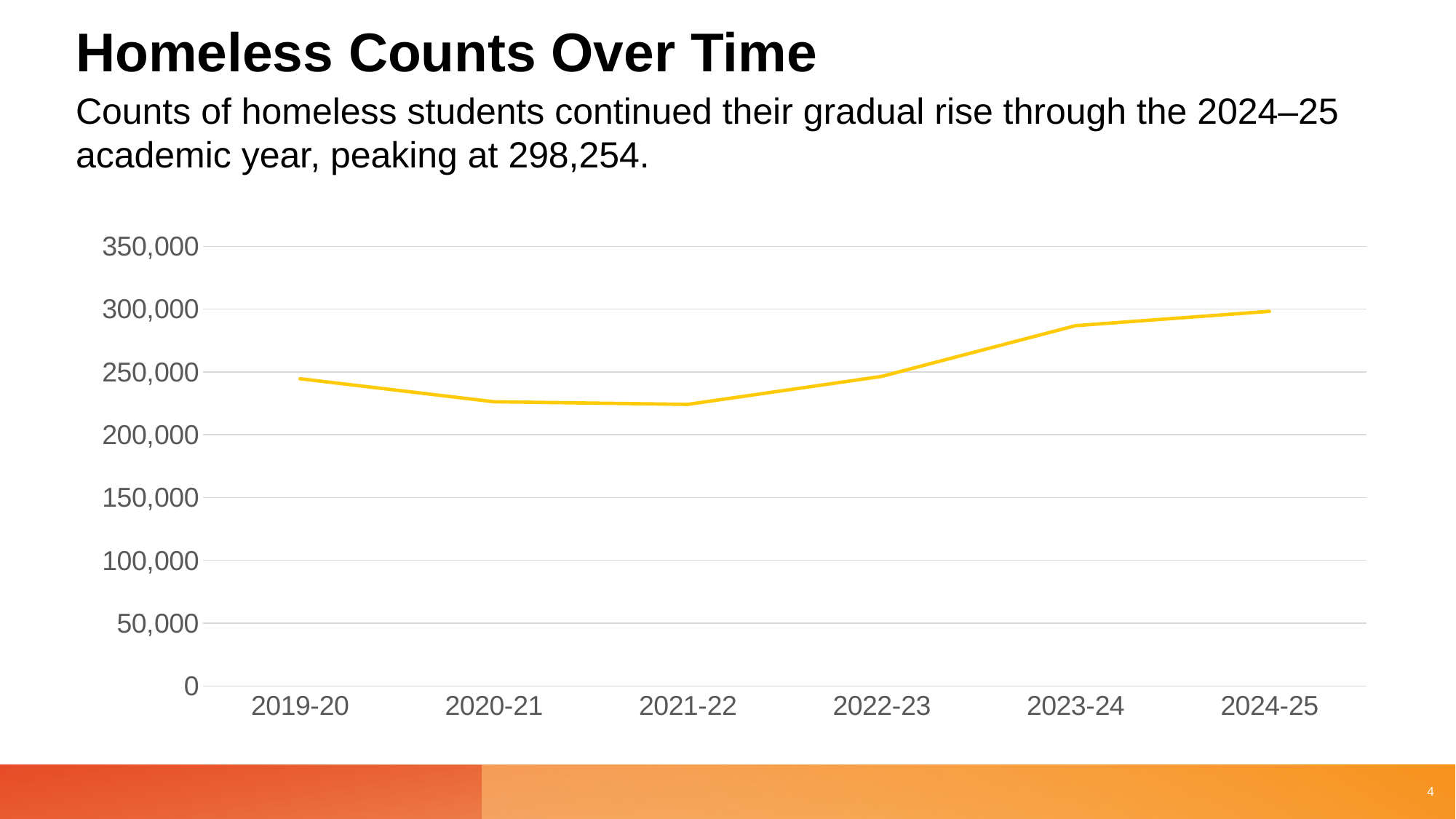
Is the value for 2024-25 greater or less than 300,000? less What colour is the line in the chart? Yellow Is the value for 2020-21 greater or less than 200,000? greater Which is larger, the value for 2019-20 or the value for 2023-24? 2023-24 Do the values rise or fall from 2021-22 to 2024-25? rise Is the value for 2021-22 greater or less than 250,000? less What kind of chart is shown on the slide? Line chart What is the homeless count for the 2024-25 academic year? 298,254 Which academic year has the highest homeless count? 2024-25 How many academic years are plotted on the x axis? 6 What is the title of the chart on the slide? Homeless Counts Over Time